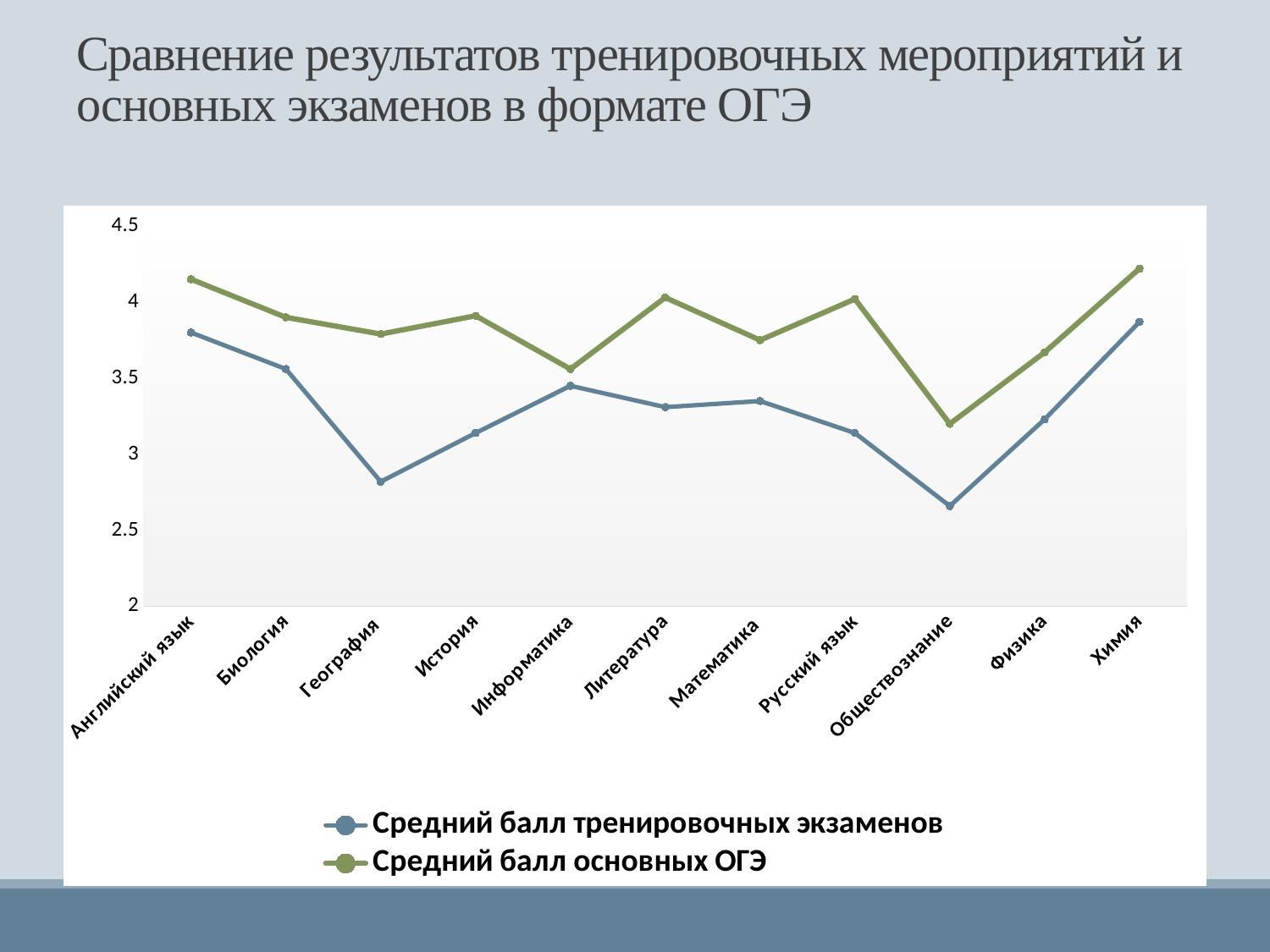
In the Средний балл тренировочных экзаменов series, does the line rise or fall from Биология to География? fall What kind of chart is shown on the slide? line chart Which subject has the lowest value for Средний балл тренировочных экзаменов? Обществознание Is the value for Обществознание in the Средний балл основных ОГЭ series greater or less than 3? greater For Математика, which series has the higher value: Средний балл тренировочных экзаменов or Средний балл основных ОГЭ? Средний балл основных ОГЭ Is the value for Химия in the Средний балл тренировочных экзаменов series greater or less than 3.5? greater Is the value for География in the Средний балл тренировочных экзаменов series greater or less than 3? less Which colour is used for the Средний балл основных ОГЭ line? green Which subject has the lowest value for Средний балл основных ОГЭ? Обществознание How many subjects are plotted along the x axis? 11 How many series does the legend list? 2